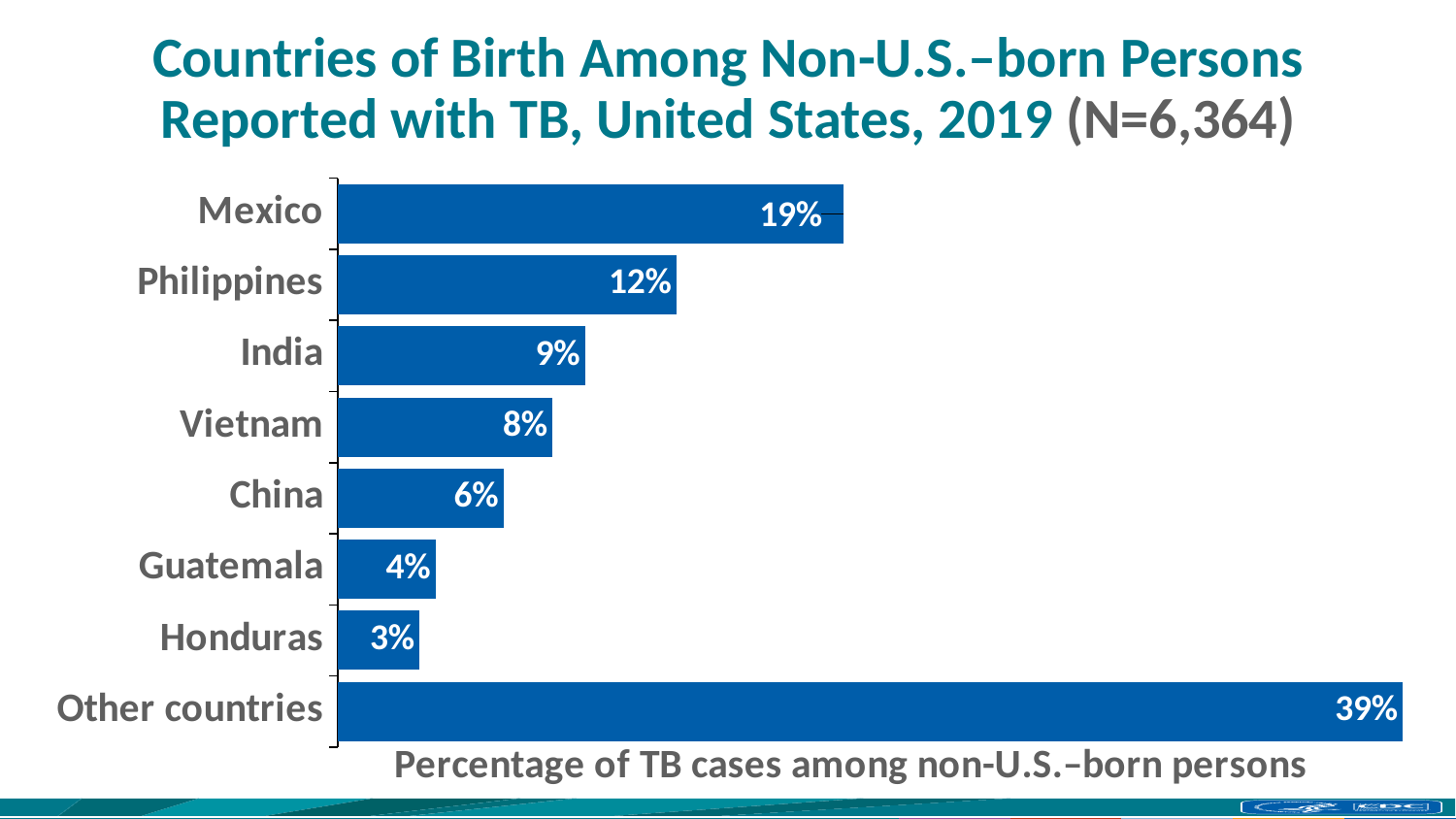
What is the value for Honduras? 3% Which has a larger percentage, Vietnam or Guatemala? Vietnam What is the difference in percentage points between India and China? 3 What kind of chart is this? Bar chart What is the x-axis label of the chart? Percentage of TB cases among non-U.S.-born persons How many categories are shown in the chart? 8 Which category has the highest percentage? Other countries What is the difference in percentage points between Mexico and the Philippines? 7 Which named country has the lowest percentage? Honduras What percentage of TB cases among non-U.S.-born persons were born in Mexico? 19% What percentage is shown for Vietnam? 8% What is the value shown for the Philippines? 12%